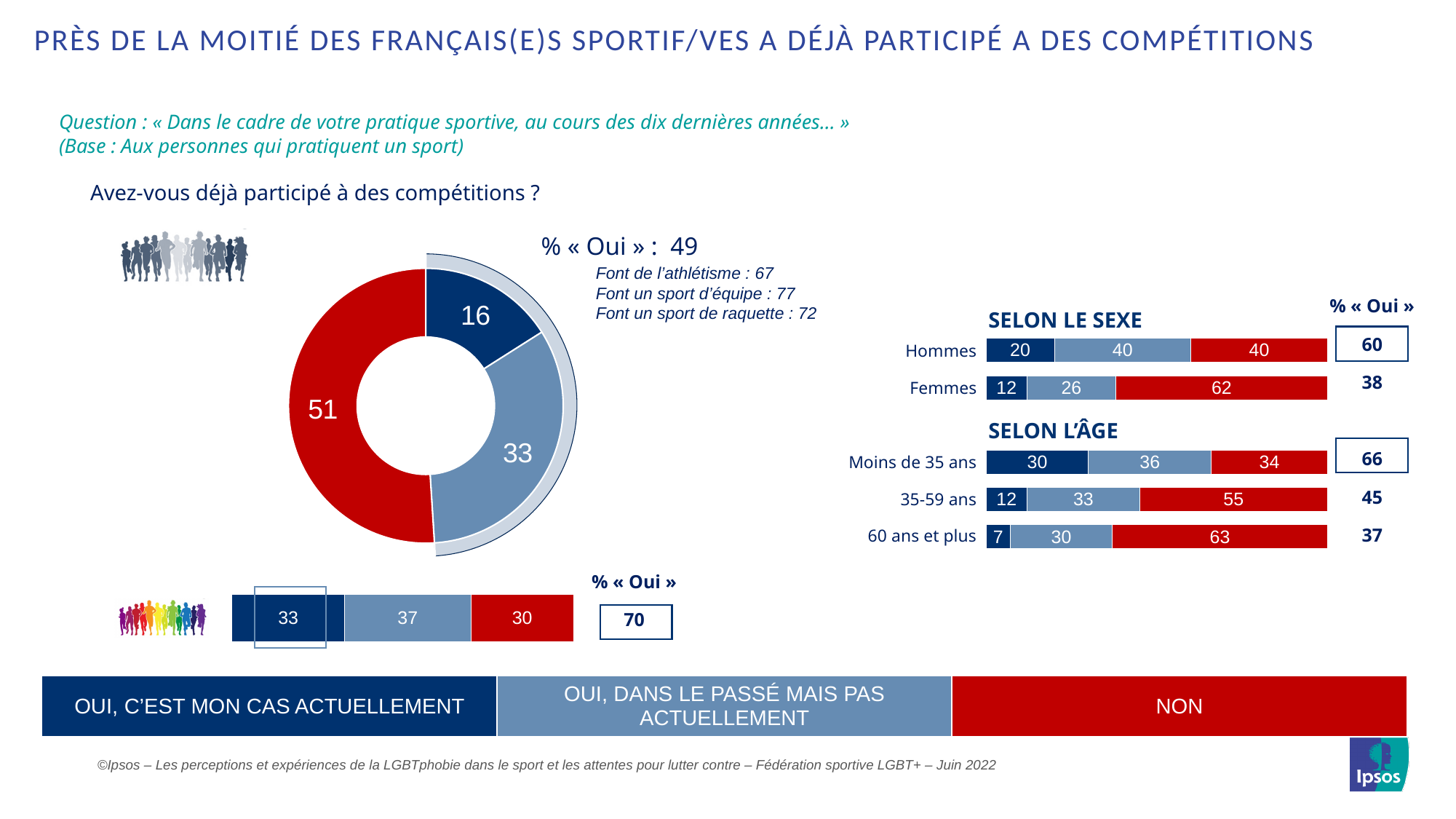
In the "Selon le sexe" bars, what is the % « Oui » for Hommes? 60 In the donut chart, what percentage answered "Non"? 51 In the donut chart, which response has the largest share? Non In the "Selon l'âge" bars, which age group has the highest % « Oui »? Moins de 35 ans In the "Selon le sexe" bars, what is the "Non" value for Femmes? 62 What kind of chart is the chart on the left showing 16, 33 and 51? Donut chart In the "Selon l'âge" bars, what is the difference between the "Non" values for 60 ans et plus and Moins de 35 ans? 29 How many categories does the legend at the bottom of the slide list? 3 In the donut chart, what is the value for "Oui, c'est mon cas actuellement"? 16 In the bottom-left stacked bar, which is larger: the "Oui, dans le passé mais pas actuellement" value or the "Non" value? Oui, dans le passé mais pas actuellement In the bottom-left stacked bar, what is the % « Oui » shown in the box? 70 In the "Selon l'âge" bars, what is the "Oui, c'est mon cas actuellement" value for 60 ans et plus? 7